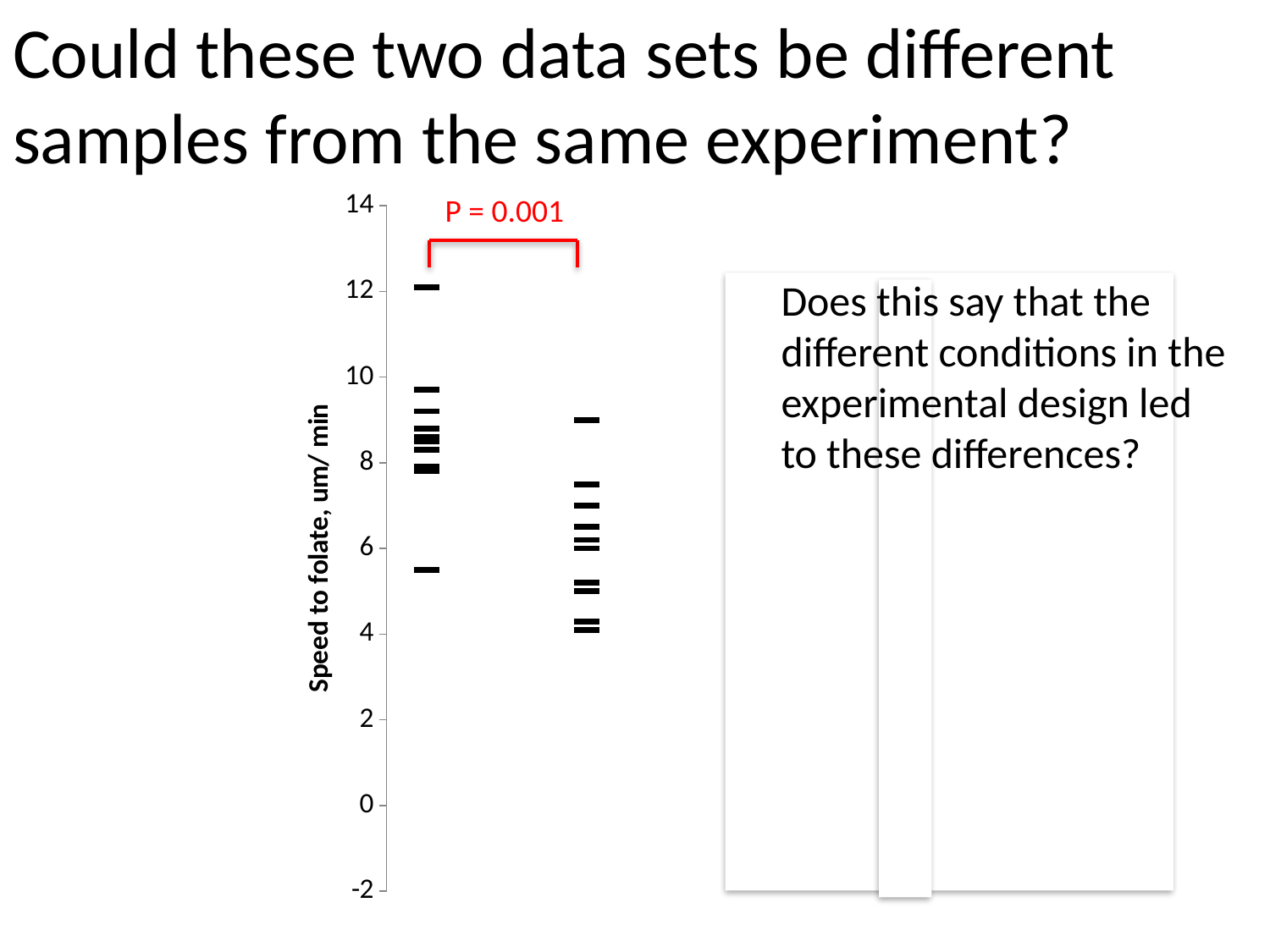
What kind of chart is shown on the slide? Scatter (dot) plot Which group, left or right, contains the lowest plotted value? Right What is the highest tick value shown on the vertical axis? 14 Is the highest point in the left group greater or less than 10? greater Is the lowest point in the left group greater or less than 4? greater How many groups (columns) of data points are plotted? 2 Is the highest point in the right group greater or less than 8? greater What is the label of the vertical axis? Speed to folate, um/ min What P value is annotated above the two groups of points? P = 0.001 Which group, left or right, contains the highest plotted value? Left